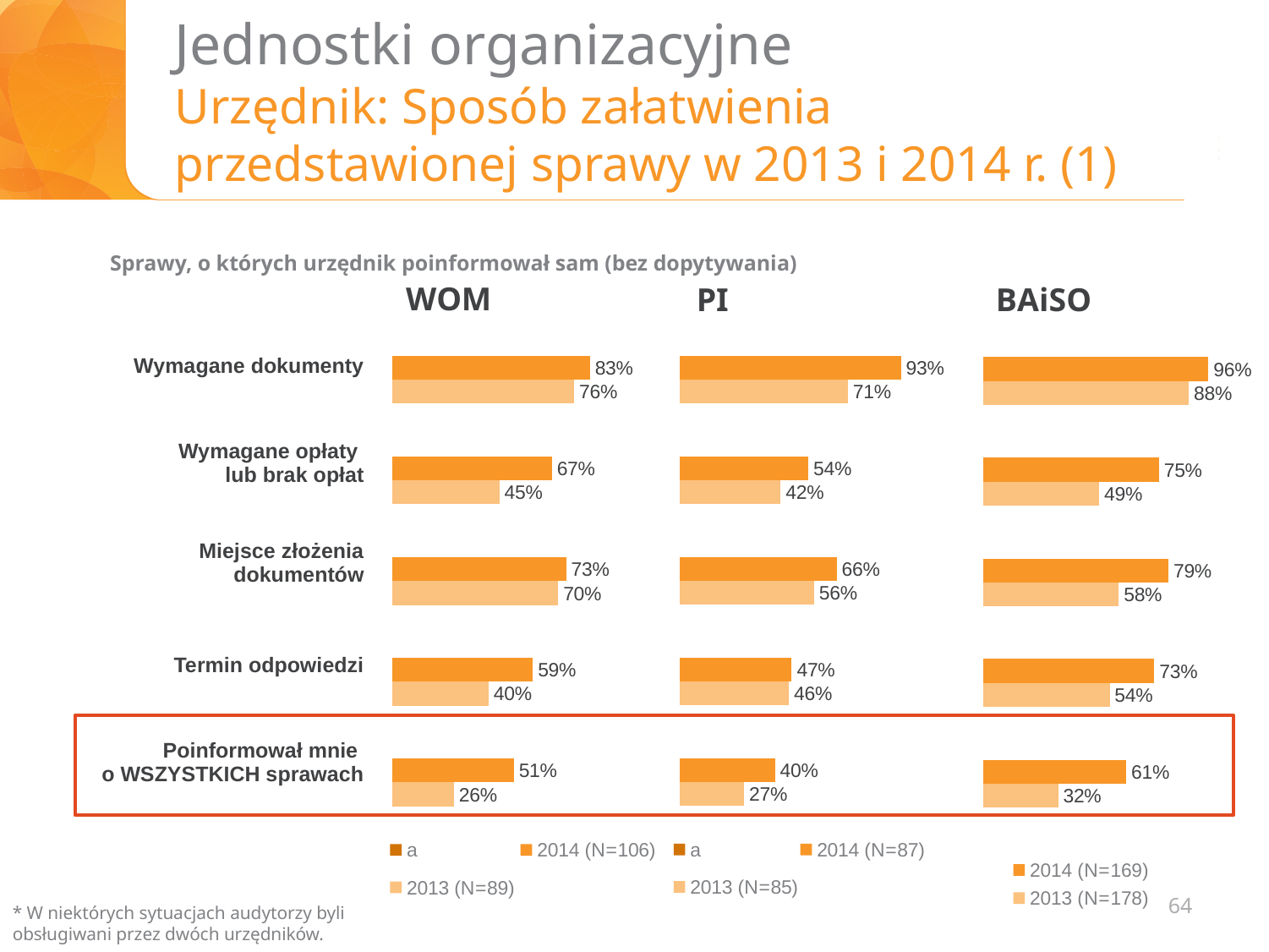
How many categories are shown in the PI chart? 5 In the WOM chart, what is the 2014 value for Wymagane dokumenty? 83% How many series does the legend of the BAiSO chart list? 2 In the BAiSO chart, what is the 2014 value for Poinformował mnie o WSZYSTKICH sprawach? 61% In the BAiSO chart, which category has the highest 2014 value? Wymagane dokumenty In the WOM chart, which is larger for Termin odpowiedzi: the 2014 value or the 2013 value? 2014 What type of chart is the WOM chart? Bar chart In the WOM chart, which category has the lowest 2013 value? Poinformował mnie o WSZYSTKICH sprawach What sample size (N) is given for 2013 in the legend of the PI chart? N=85 In the BAiSO chart, what is the difference between the 2014 and 2013 values for Wymagane opłaty lub brak opłat? 26 percentage points In the PI chart, what is the difference between the 2014 and 2013 values for Wymagane dokumenty? 22 percentage points In the PI chart, what is the 2013 value for Wymagane opłaty lub brak opłat? 42%